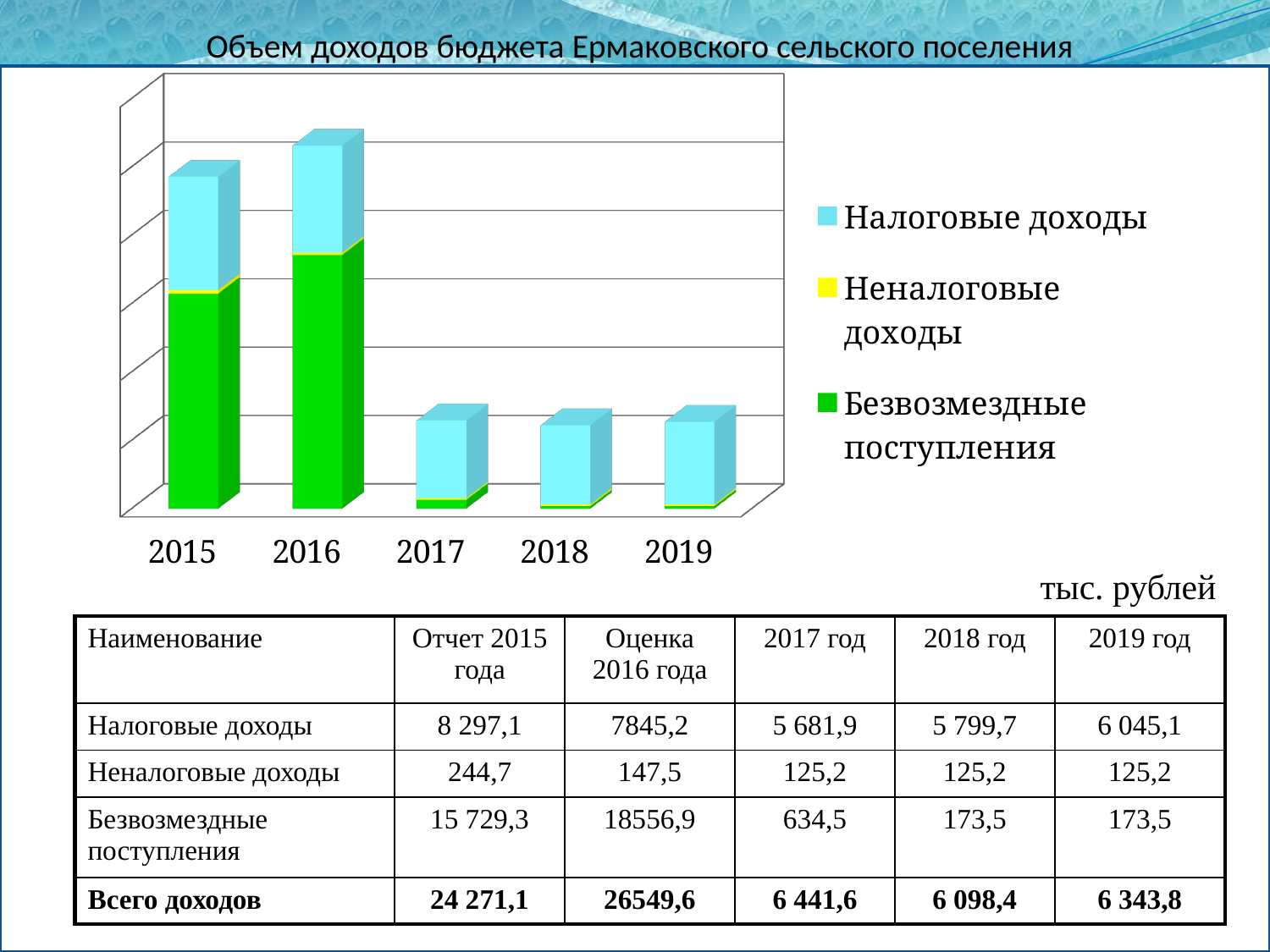
What kind of chart is shown on the slide? bar chart According to the table under the chart, what is the value of Налоговые доходы for 2017? 5 681,9 Which series forms the largest part of the 2017 bar? Налоговые доходы Using the table values, what is the difference between Неналоговые доходы in 2015 (244,7) and 2016 (147,5)? 97,2 Which colour represents Безвозмездные поступления in the chart legend? green How many series does the chart legend list? 3 Which year has the largest Безвозмездные поступления segment in the chart? 2016 According to the table under the chart, what is the value of Всего доходов for Оценка 2016 года? 26549,6 Do the total bar heights rise or fall from 2016 to 2017? fall How many years are shown along the x axis of the chart? 5 Which year has the tallest stacked bar in the chart? 2016 Which is larger in the chart: the total bar for 2015 or for 2016? 2016